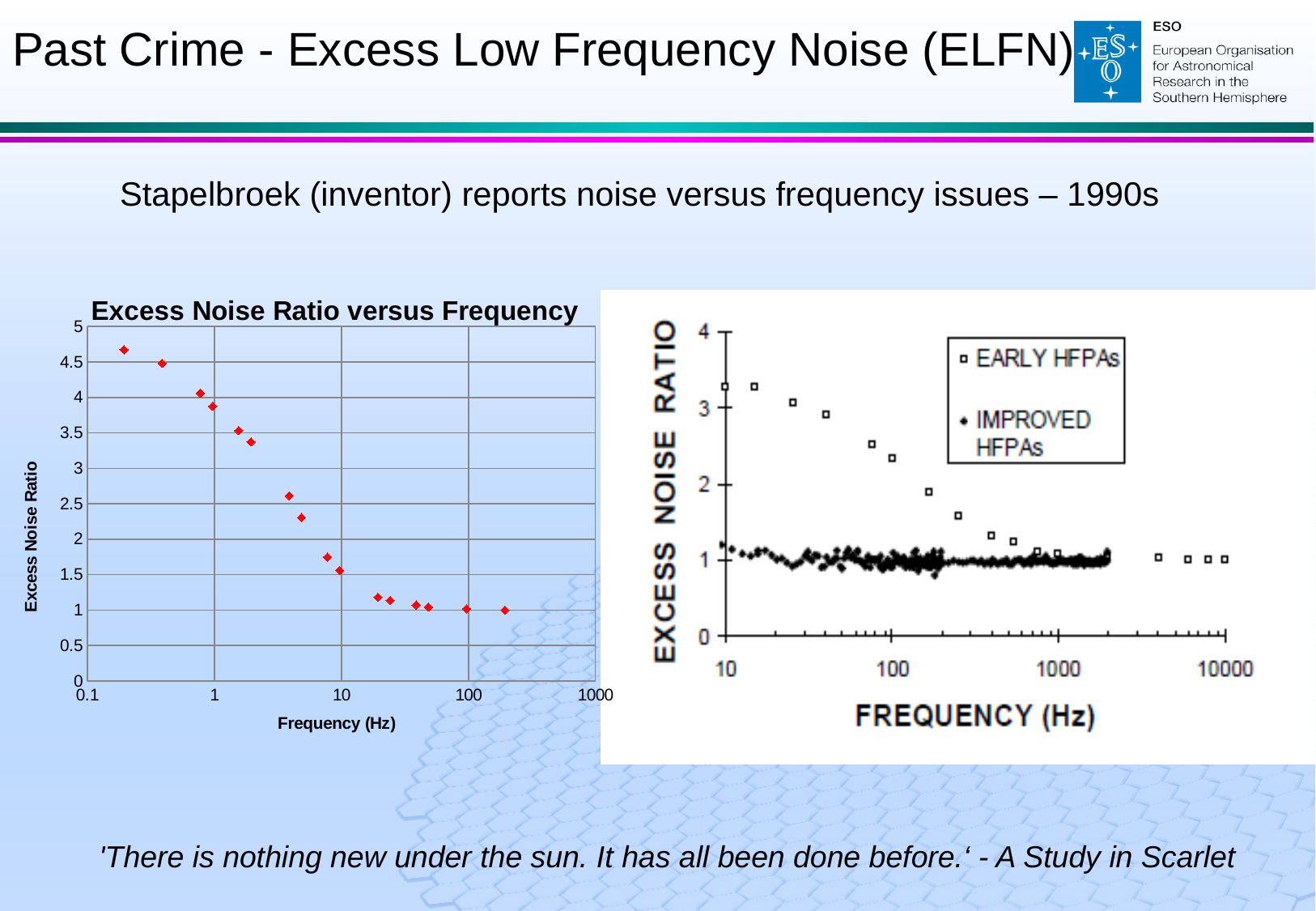
In the 'Excess Noise Ratio versus Frequency' chart on the left, is the excess noise ratio at 10 Hz greater or less than 2? less What is the label of the x axis of the 'Excess Noise Ratio versus Frequency' chart on the left? Frequency (Hz) In the 'Excess Noise Ratio versus Frequency' chart on the left, do the values rise or fall as frequency increases? fall What kind of chart is the 'Excess Noise Ratio versus Frequency' chart on the left? scatter chart In the chart on the right, do the EARLY HFPAs values rise or fall as frequency increases? fall In the 'Excess Noise Ratio versus Frequency' chart on the left, which has the higher excess noise ratio: the point at 1 Hz or the point at 10 Hz? 1 Hz How many series does the legend of the chart on the right list? 2 In the chart on the right, which series has the higher excess noise ratio at 10 Hz: EARLY HFPAs or IMPROVED HFPAs? EARLY HFPAs In the 'Excess Noise Ratio versus Frequency' chart on the left, is the excess noise ratio at 100 Hz greater or less than 1.5? less What is the highest value shown on the y axis of the 'Excess Noise Ratio versus Frequency' chart on the left? 5 In the chart on the right, is the excess noise ratio of EARLY HFPAs at 10 Hz greater or less than 3? greater